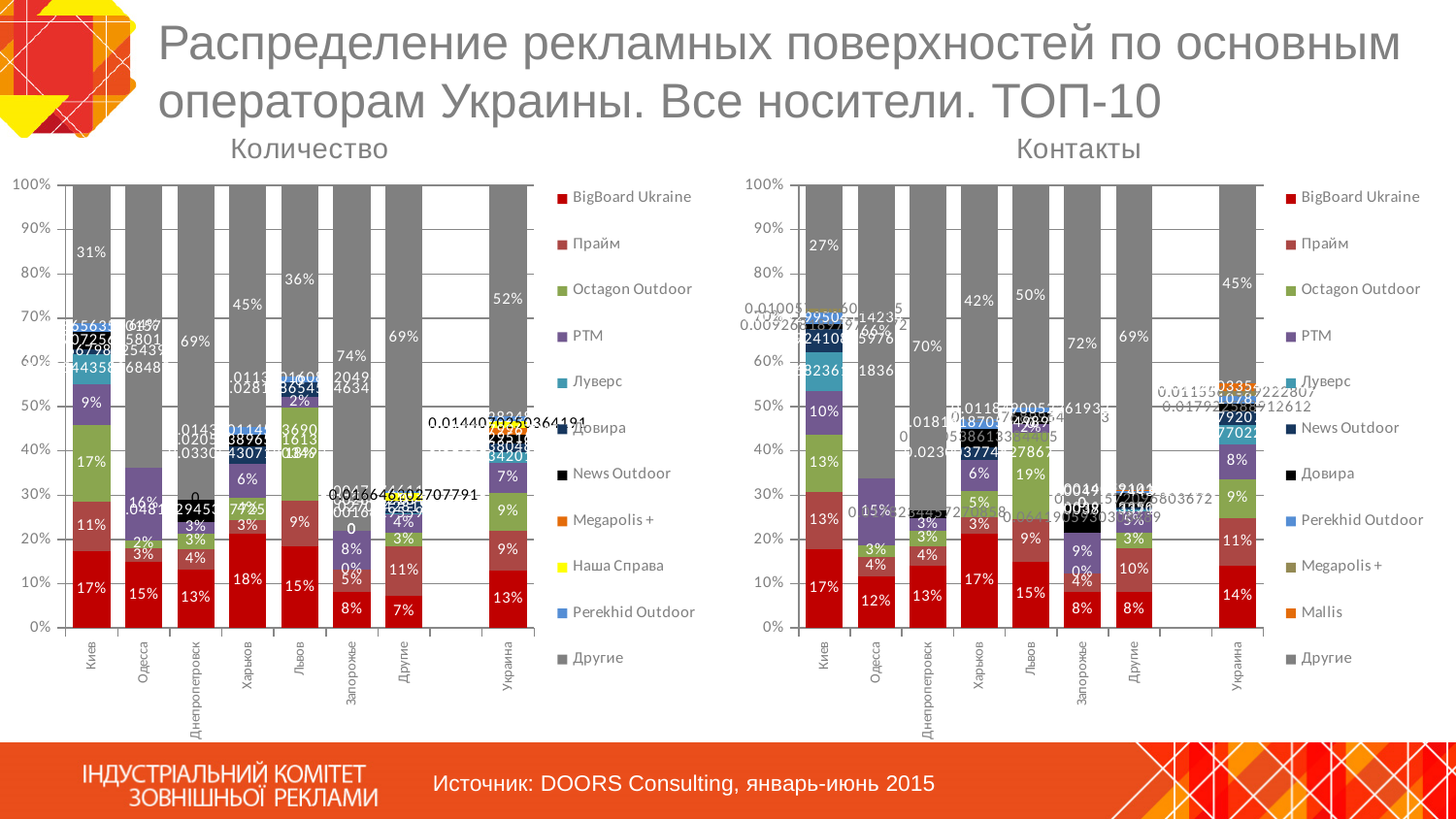
In the Количество chart, what share does Другие have in Запорожье? 74% How many series does the legend of the Контакты chart list? 11 In the Контакты chart, what share does Другие have in Киев? 27% What type of chart is the Количество chart? Stacked bar chart In the Количество chart, which city has the largest BigBoard Ukraine share? Харьков How many categories are shown on the x axis of the Количество chart? 8 In the Количество chart, what is the difference between the Другие share in Днепропетровск and in Киев? 38% In the Контакты chart, which is larger: the Другие share in Запорожье or in Харьков? Запорожье In the Количество chart, what share does BigBoard Ukraine have in Киев? 17% In the Контакты chart, what share does Другие have in Львов? 50% In the Количество chart, what share does Другие have in Украина? 52% In the Контакты chart, what share does BigBoard Ukraine have in Украина? 14%